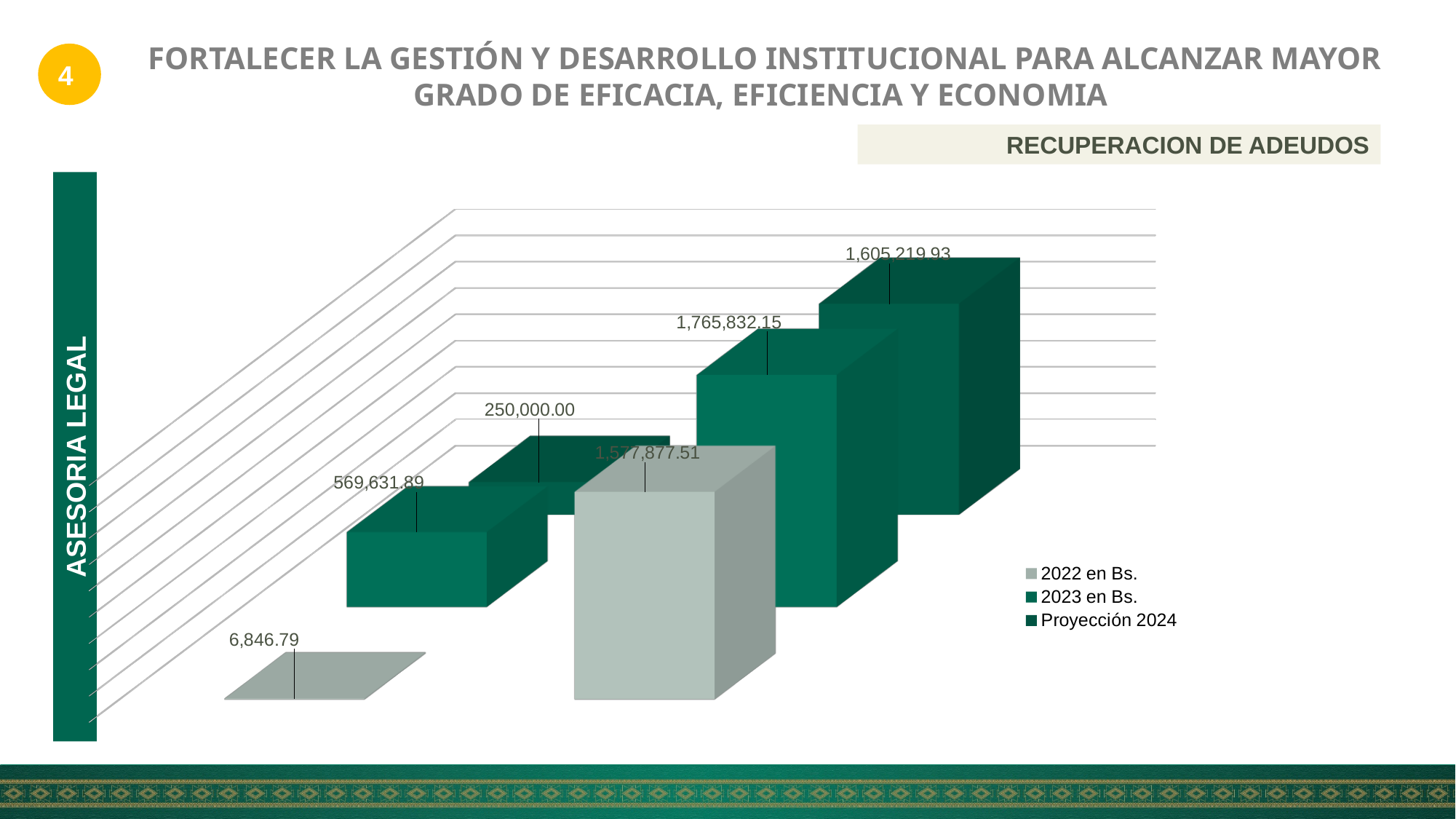
What is the difference between the 2023 en Bs. value (569,631.89) and the Proyección 2024 value (250,000.00) in the left-hand group? 319,631.89 What kind of chart is shown under the heading RECUPERACION DE ADEUDOS? Bar chart How many bars are plotted in total on the chart? 6 What are the three legend entries of the RECUPERACION DE ADEUDOS chart? 2022 en Bs., 2023 en Bs., Proyección 2024 What is the difference between the 2023 en Bs. value (1,765,832.15) and the 2022 en Bs. value (1,577,877.51) in the right-hand group? 187,954.64 What is the value of the Proyección 2024 bar in the right-hand group of bars? 1,605,219.93 In the right-hand group of bars, which is larger: the 2023 en Bs. value or the Proyección 2024 value? 2023 en Bs. What is the smallest value labelled on the chart, belonging to the 2022 en Bs. series? 6,846.79 How many series does the legend of the RECUPERACION DE ADEUDOS chart list? 3 What is the value of the Proyección 2024 bar in the left-hand group of bars? 250,000.00 What is the larger of the two values plotted for the 2023 en Bs. series? 1,765,832.15 Which series has the highest value on the chart? 2023 en Bs.